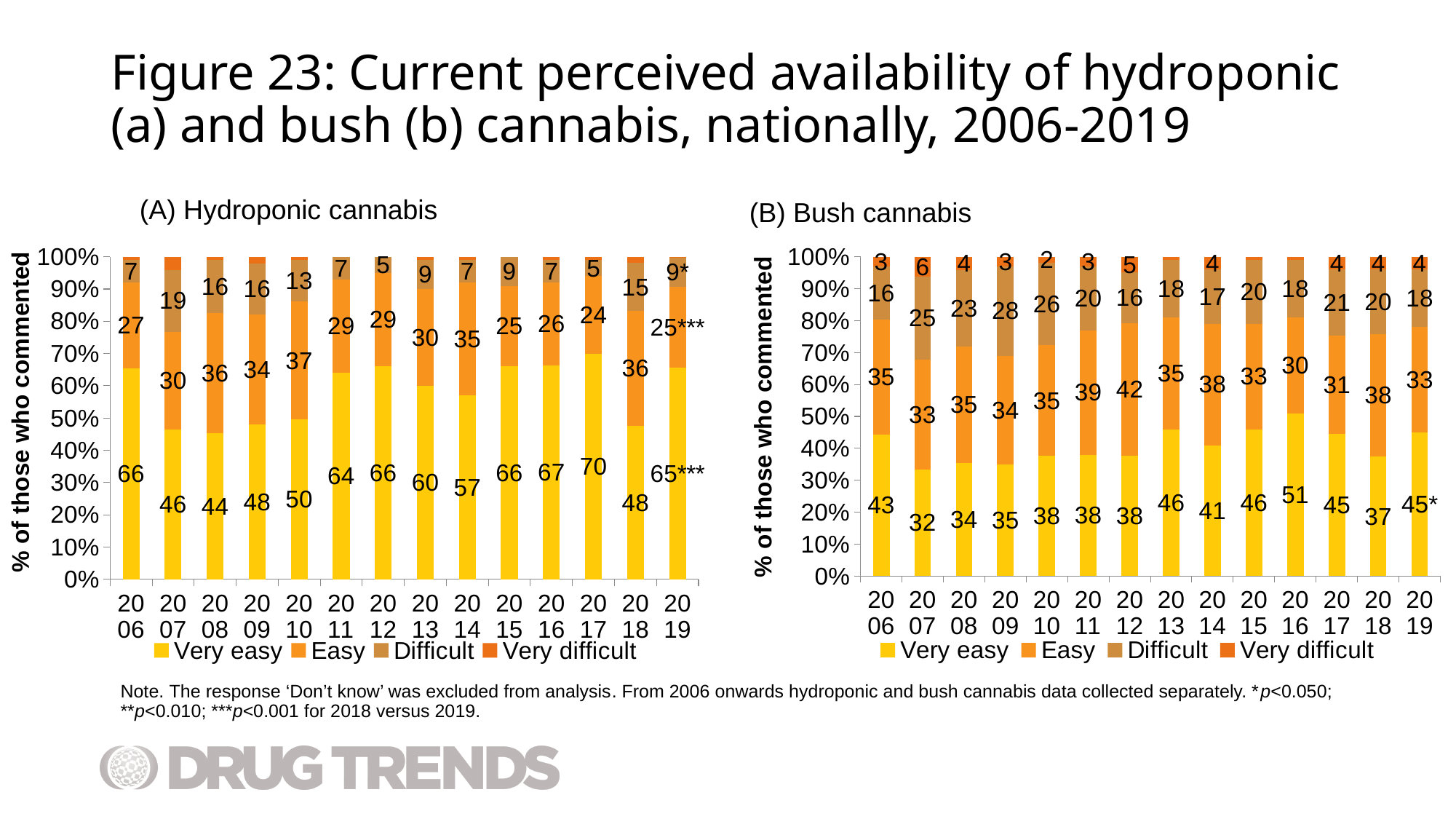
In chart (A) Hydroponic cannabis, what is the difference between the 'Very easy' values for 2017 and 2018? 22 In chart (B) Bush cannabis, what is the 'Difficult' value for 2009? 28 In chart (A) Hydroponic cannabis, which year has the highest 'Very easy' value? 2017 In chart (B) Bush cannabis, which year has the lowest 'Very easy' value? 2007 Which chart has the larger 'Very easy' value for 2006, (A) Hydroponic cannabis or (B) Bush cannabis? (A) Hydroponic cannabis In chart (A) Hydroponic cannabis, what is the 'Very easy' value for 2017? 70 In chart (B) Bush cannabis, what is the 'Very difficult' value for 2007? 6 In chart (A) Hydroponic cannabis, what is the 'Easy' value for 2010? 37 In chart (A) Hydroponic cannabis, which year has the highest 'Difficult' value? 2007 How many years are shown on the x axis of chart (B) Bush cannabis? 14 How many series does the legend of chart (A) Hydroponic cannabis list? 4 In chart (B) Bush cannabis, what is the difference between the 'Difficult' values for 2009 and 2006? 12